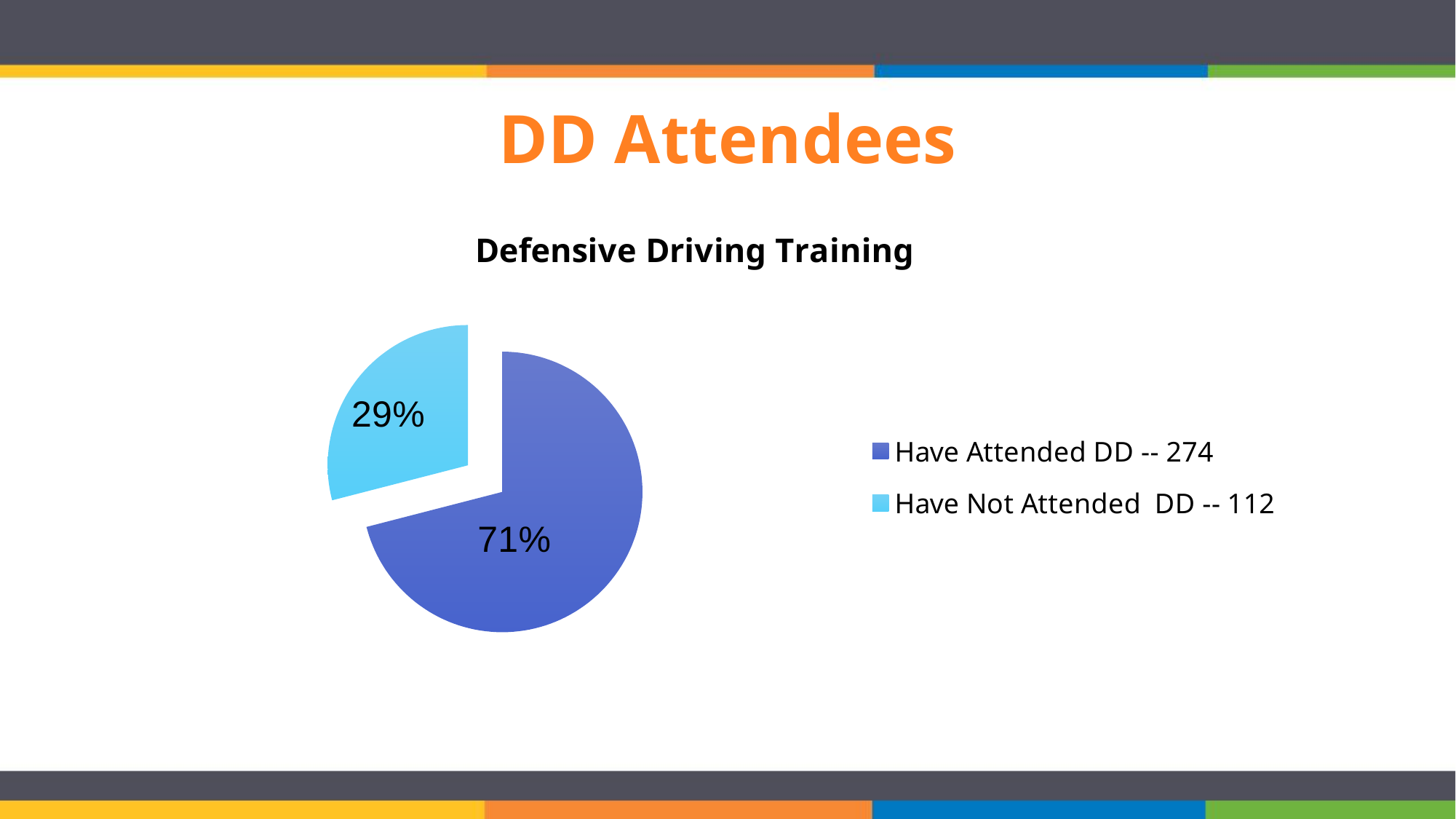
Which is larger: the 'Have Attended DD' slice or the 'Have Not Attended DD' slice? Have Attended DD Which slice of the pie is the smallest? Have Not Attended DD What percentage of the pie is labelled for the 'Have Attended DD' slice? 71% According to the legend, how many people have not attended DD? 112 How many slices does the pie chart have? 2 According to the legend, how many people have attended DD? 274 What type of chart is shown on the slide? Pie chart What is the difference in percentage points between the 'Have Attended DD' slice and the 'Have Not Attended DD' slice? 42 percentage points How many entries does the legend list? 2 What is the title of the chart? Defensive Driving Training What percentage of the pie is labelled for the 'Have Not Attended DD' slice? 29% Which slice of the pie is the largest? Have Attended DD